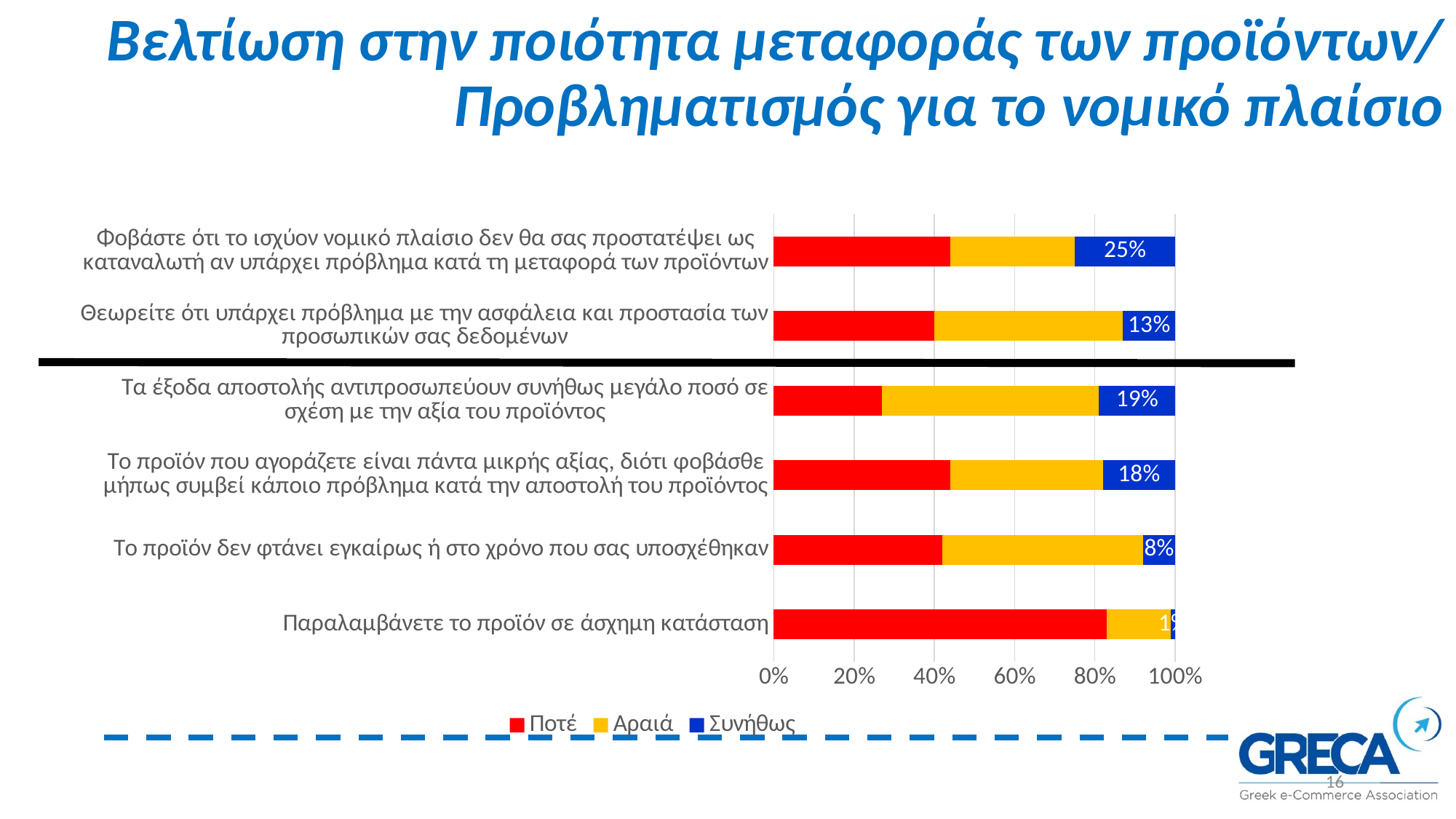
What is the value of the Συνήθως series for "Φοβάστε ότι το ισχύον νομικό πλαίσιο δεν θα σας προστατέψει ως καταναλωτή αν υπάρχει πρόβλημα κατά τη μεταφορά των προϊόντων"? 25% What is the value of the Συνήθως series for "Το προϊόν δεν φτάνει εγκαίρως ή στο χρόνο που σας υποσχέθηκαν"? 8% Is the Ποτέ value for "Παραλαμβάνετε το προϊόν σε άσχημη κατάσταση" greater or less than 60%? greater What is the difference between the Συνήθως values for "Φοβάστε ότι το ισχύον νομικό πλαίσιο..." (25%) and "Θεωρείτε ότι υπάρχει πρόβλημα με την ασφάλεια..." (13%)? 12 percentage points What is the value of the Συνήθως series for "Παραλαμβάνετε το προϊόν σε άσχημη κατάσταση"? 1% What is the value of the Συνήθως series for "Θεωρείτε ότι υπάρχει πρόβλημα με την ασφάλεια και προστασία των προσωπικών σας δεδομένων"? 13% Is the Ποτέ value for "Τα έξοδα αποστολής αντιπροσωπεύουν συνήθως μεγάλο ποσό σε σχέση με την αξία του προϊόντος" greater or less than 40%? less How many series does the legend list? 3 Which category has the highest Συνήθως value? Φοβάστε ότι το ισχύον νομικό πλαίσιο δεν θα σας προστατέψει ως καταναλωτή αν υπάρχει πρόβλημα κατά τη μεταφορά των προϊόντων How many categories (statements) are shown in the chart? 6 Which has a larger Συνήθως value: "Τα έξοδα αποστολής αντιπροσωπεύουν συνήθως μεγάλο ποσό σε σχέση με την αξία του προϊόντος" or "Το προϊόν που αγοράζετε είναι πάντα μικρής αξίας..."? Τα έξοδα αποστολής αντιπροσωπεύουν συνήθως μεγάλο ποσό σε σχέση με την αξία του προϊόντος Which category has the lowest Συνήθως value? Παραλαμβάνετε το προϊόν σε άσχημη κατάσταση